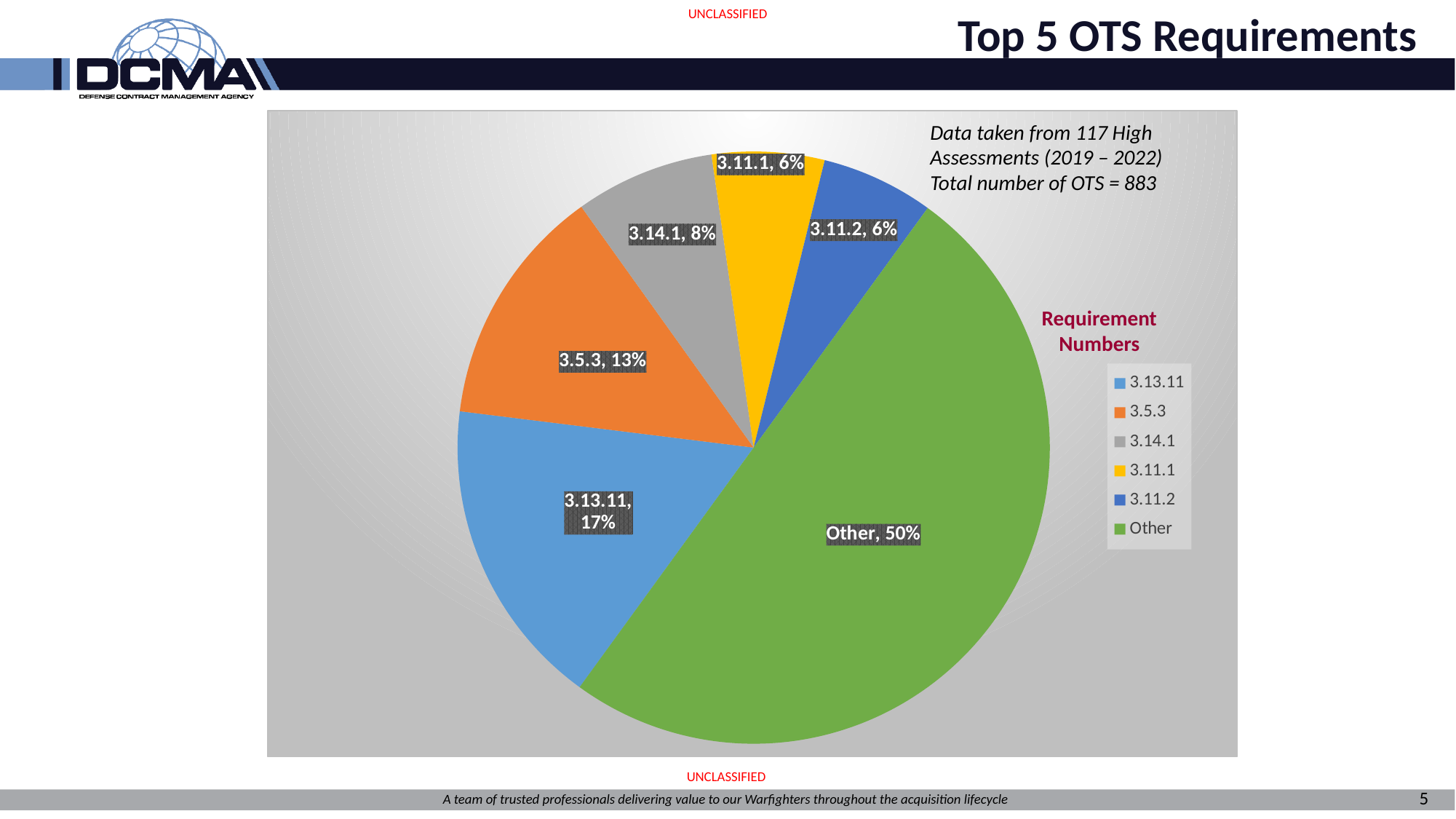
What type of chart is shown on the slide? pie chart What is the title of the legend? Requirement Numbers What colour is the slice for 3.11.1? yellow What is the difference in percentage points between 3.13.11 and 3.5.3? 4% What share of the pie does 3.5.3 represent? 13% What share of the pie does 3.14.1 represent? 8% Which slice of the pie is the largest? Other What share of the pie does Other represent? 50% Which is larger, the share for 3.14.1 or the share for 3.5.3? 3.5.3 How many slices does the pie chart have? 6 Which of the top 5 requirements has the largest share? 3.13.11